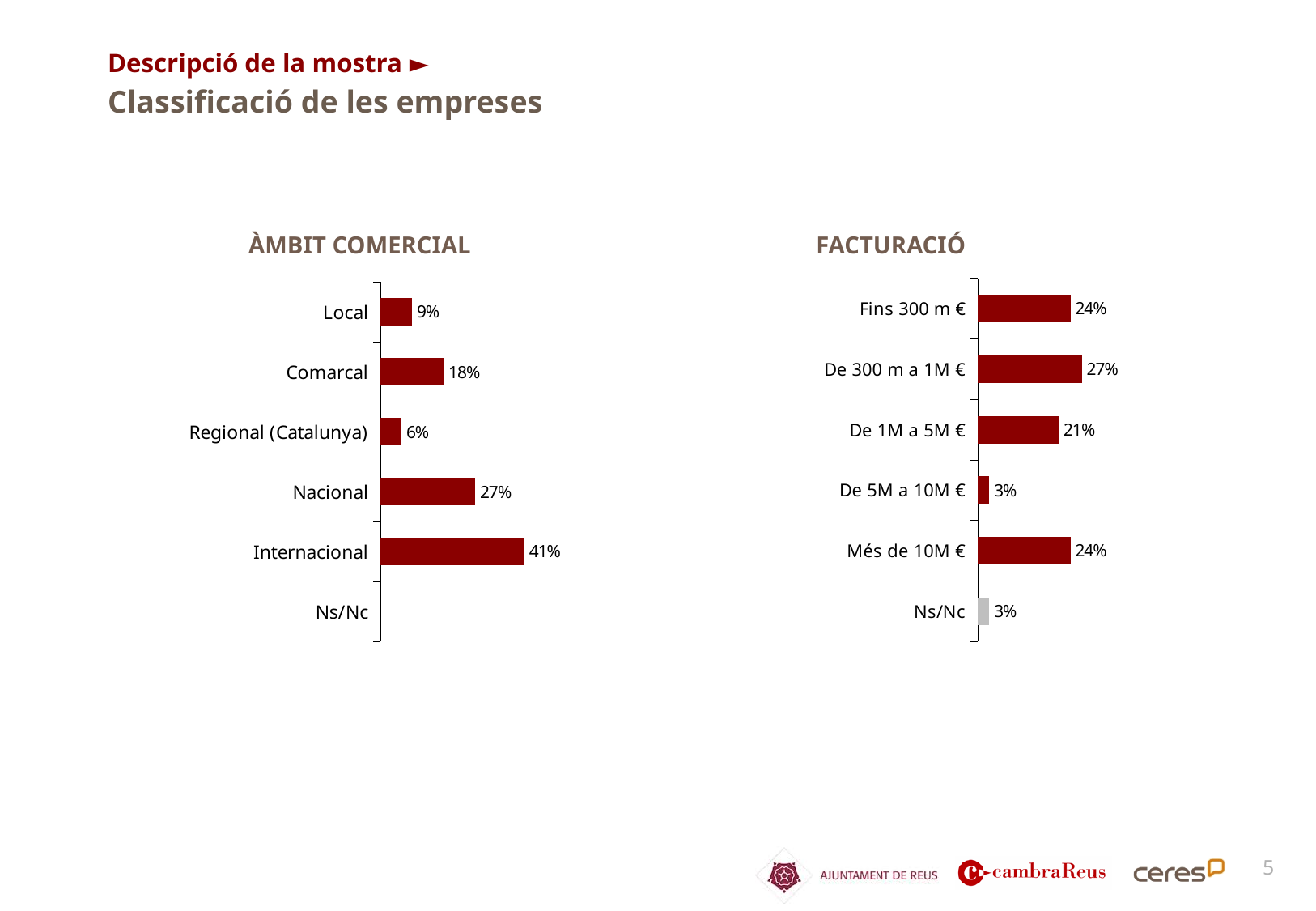
In the FACTURACIÓ chart, which category has the highest value? De 300 m a 1M € In the ÀMBIT COMERCIAL chart, which category has the highest value? Internacional What kind of chart is the FACTURACIÓ chart? Bar chart In the ÀMBIT COMERCIAL chart, what is the value for Internacional? 41% In the ÀMBIT COMERCIAL chart, what is the value for Comarcal? 18% In the ÀMBIT COMERCIAL chart, which is larger, Comarcal or Regional (Catalunya)? Comarcal In the FACTURACIÓ chart, what is the value for De 1M a 5M €? 21% How many categories are listed in the ÀMBIT COMERCIAL chart? 6 In the FACTURACIÓ chart, which bar is shown in grey rather than dark red? Ns/Nc In the ÀMBIT COMERCIAL chart, what is the difference between Nacional and Local? 18% In the FACTURACIÓ chart, what is the difference between De 300 m a 1M € and De 5M a 10M €? 24% In the FACTURACIÓ chart, what is the value for Ns/Nc? 3%